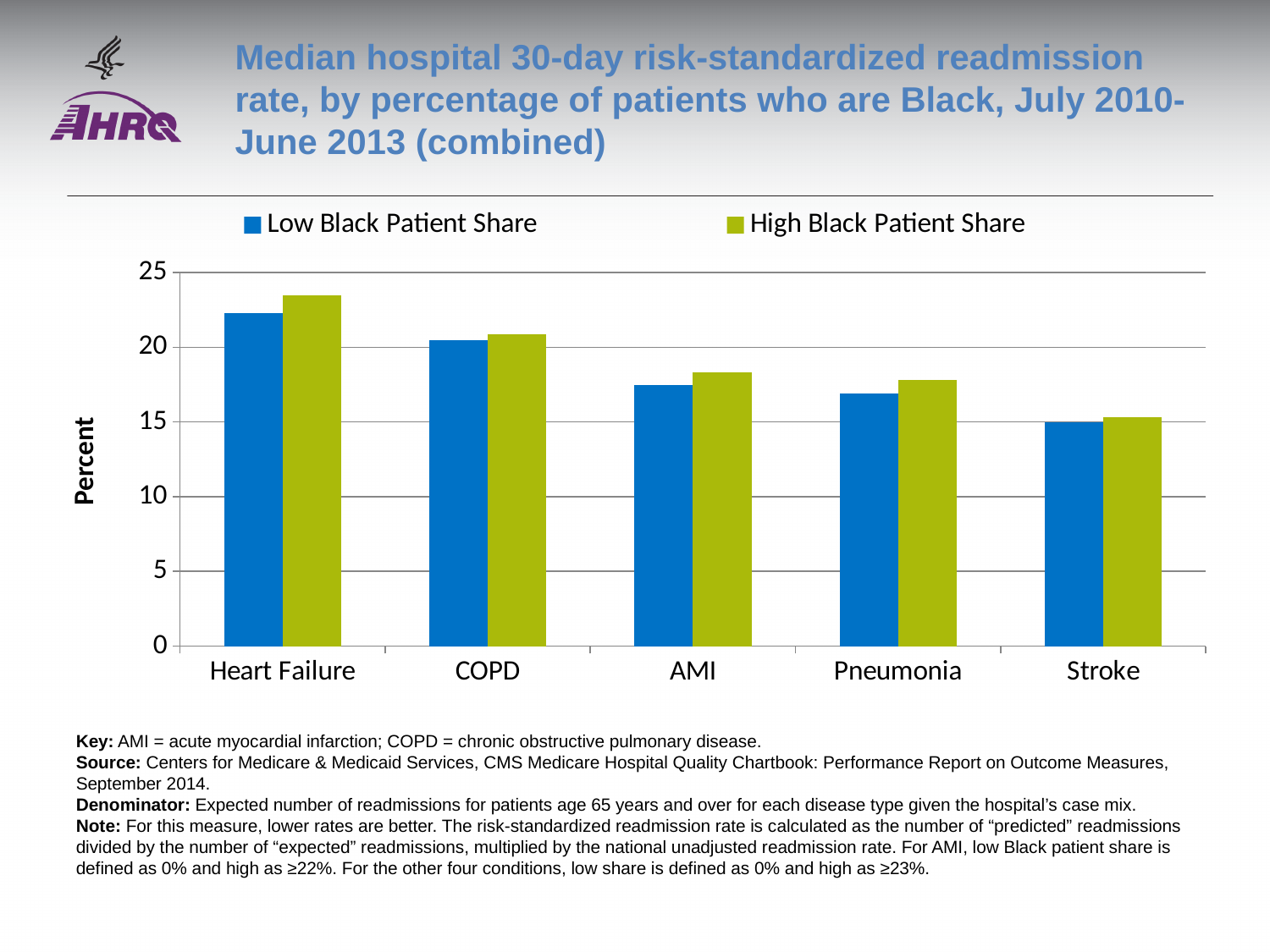
How many series does the legend list? 2 For Heart Failure, which is larger: the Low Black Patient Share value or the High Black Patient Share value? High Black Patient Share Which condition has the lowest readmission rate for the Low Black Patient Share series? Stroke Is the Low Black Patient Share value for COPD greater or less than 15? greater What kind of chart is shown on the slide? bar chart How many conditions are shown on the x axis? 5 Which is larger: the Low Black Patient Share value for Heart Failure or the High Black Patient Share value for COPD? Low Black Patient Share value for Heart Failure Which condition has the highest readmission rate for the High Black Patient Share series? Heart Failure Is the Low Black Patient Share value for Heart Failure greater or less than 20? greater Is the High Black Patient Share value for AMI greater or less than 20? less Do the readmission rates rise or fall moving from Heart Failure to Stroke along the x axis? fall What is the label on the y axis? Percent